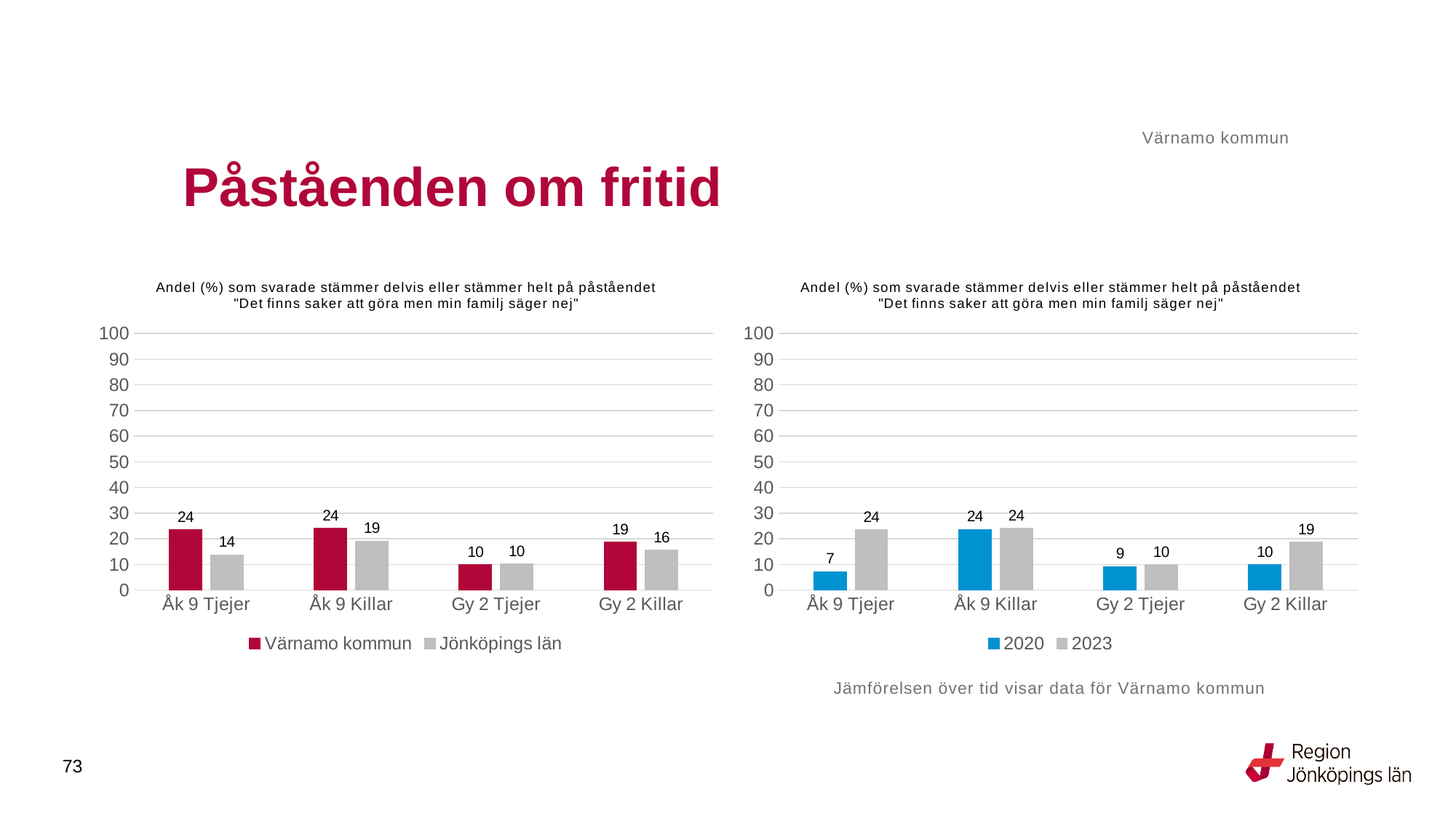
In the left chart, which category has the lowest value for Värnamo kommun? Gy 2 Tjejer In the left chart, what is the value for Jönköpings län for Gy 2 Killar? 16 In the right chart, what is the value for 2020 for Åk 9 Tjejer? 7 In the right chart, which is larger for Gy 2 Killar: 2020 or 2023? 2023 In the left chart, what is the value for Värnamo kommun for Åk 9 Tjejer? 24 In the left chart, what is the difference between Värnamo kommun and Jönköpings län for Åk 9 Tjejer? 10 What kind of chart is the left chart? Bar chart In the right chart, what is the value for 2023 for Gy 2 Killar? 19 How many categories are shown on the x axis of the left chart? 4 How many series does the legend of the right chart list? 2 In the right chart, what is the difference between 2023 and 2020 for Åk 9 Tjejer? 17 In the right chart, which category has the highest value for 2023? Åk 9 Tjejer and Åk 9 Killar (tied at 24)